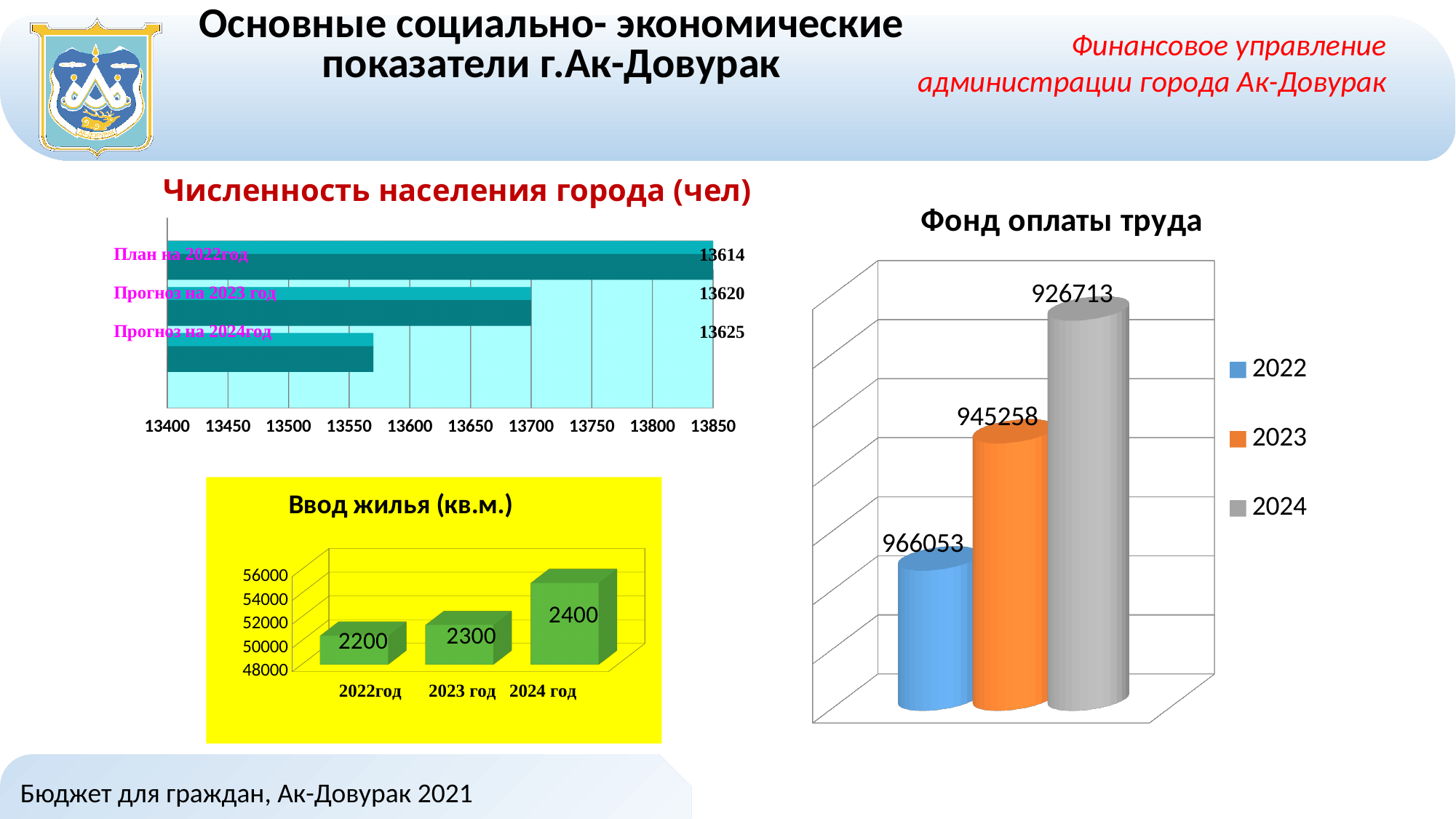
In the chart 'Фонд оплаты труда', which year has the lowest value? 2024 How many entries does the legend of the chart 'Фонд оплаты труда' list? 3 How many categories does the chart 'Численность населения города (чел)' show? 3 In the chart 'Численность населения города (чел)', what value is shown for 'Прогноз на 2024год'? 13625 In the chart 'Численность населения города (чел)', what value is shown for 'План на 2022год'? 13614 In the chart 'Фонд оплаты труда', what is the difference between the values for 2022 and 2024? 39340 In the chart 'Ввод жилья (кв.м.)', which year has the highest value? 2024 год In the chart 'Ввод жилья (кв.м.)', do the values rise or fall from 2022 to 2024? rise In the chart 'Ввод жилья (кв.м.)', what is the difference between the values for 2024 год and 2022год? 200 In the chart 'Ввод жилья (кв.м.)', what value is shown for '2023 год'? 2300 What kind of chart is 'Численность населения города (чел)'? bar chart In the chart 'Фонд оплаты труда', what value is shown for 2023? 945258